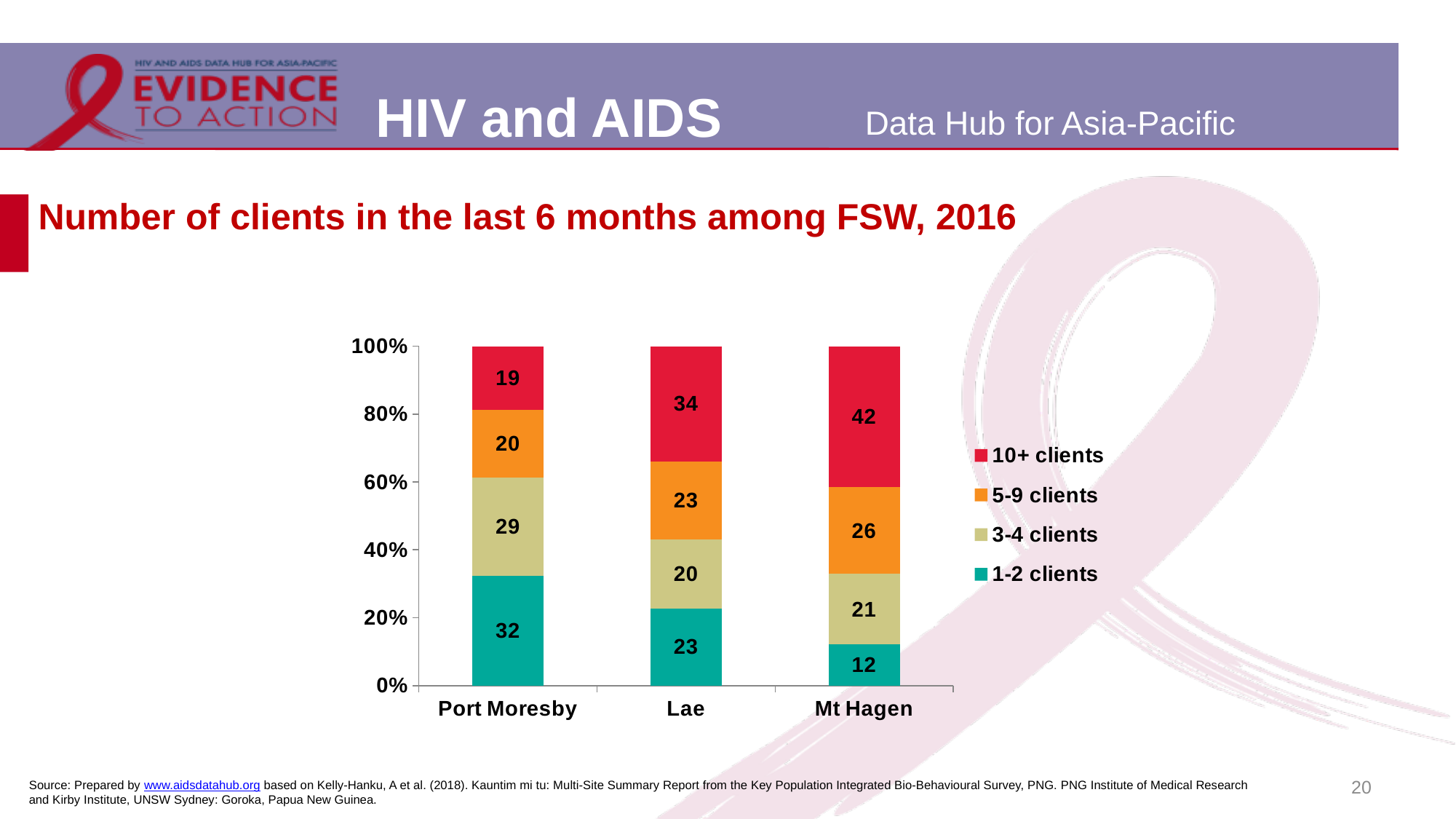
Which city has the highest value for 10+ clients? Mt Hagen What is the difference between the 10+ clients values for Mt Hagen and Port Moresby? 23 How many cities are shown on the x axis? 3 Which is larger: the 3-4 clients value for Port Moresby or for Mt Hagen? Port Moresby How many series does the legend list? 4 What is the value for 10+ clients in Mt Hagen? 42 Which city has the lowest value for 1-2 clients? Mt Hagen What is the value for 5-9 clients in Mt Hagen? 26 What kind of chart is shown on the slide? Stacked bar chart Which legend entry is shown in red? 10+ clients What is the value for 1-2 clients in Port Moresby? 32 What is the value for 3-4 clients in Lae? 20